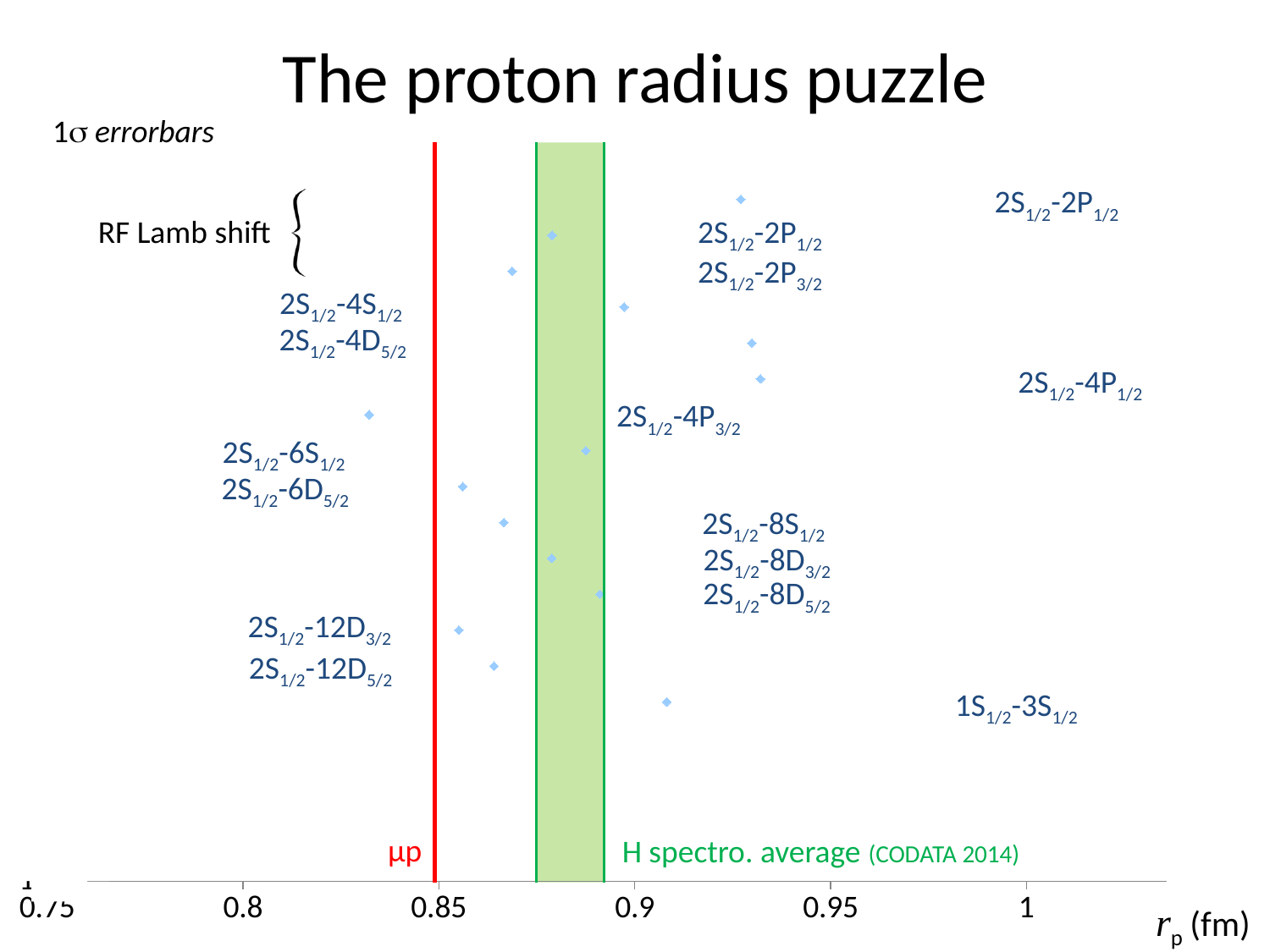
What is the label of the red vertical line? μp What is the label of the x axis? r_p (fm) What is the highest tick value shown on the x axis? 1 What size of errorbars does the slide say are shown? 1σ errorbars What is the label of the green shaded band? H spectro. average (CODATA 2014) What is the lowest tick value shown on the x axis? 0.75 What kind of chart is shown on the slide? scatter chart Is the H spectro. average band greater or less than 0.85 fm? greater Is the μp line greater or less than 0.9 fm? less Which source is cited for the H spectro. average band? CODATA 2014 Which is larger, the μp value or the H spectro. average? H spectro. average Is the leftmost data point greater or less than 0.85 fm? less